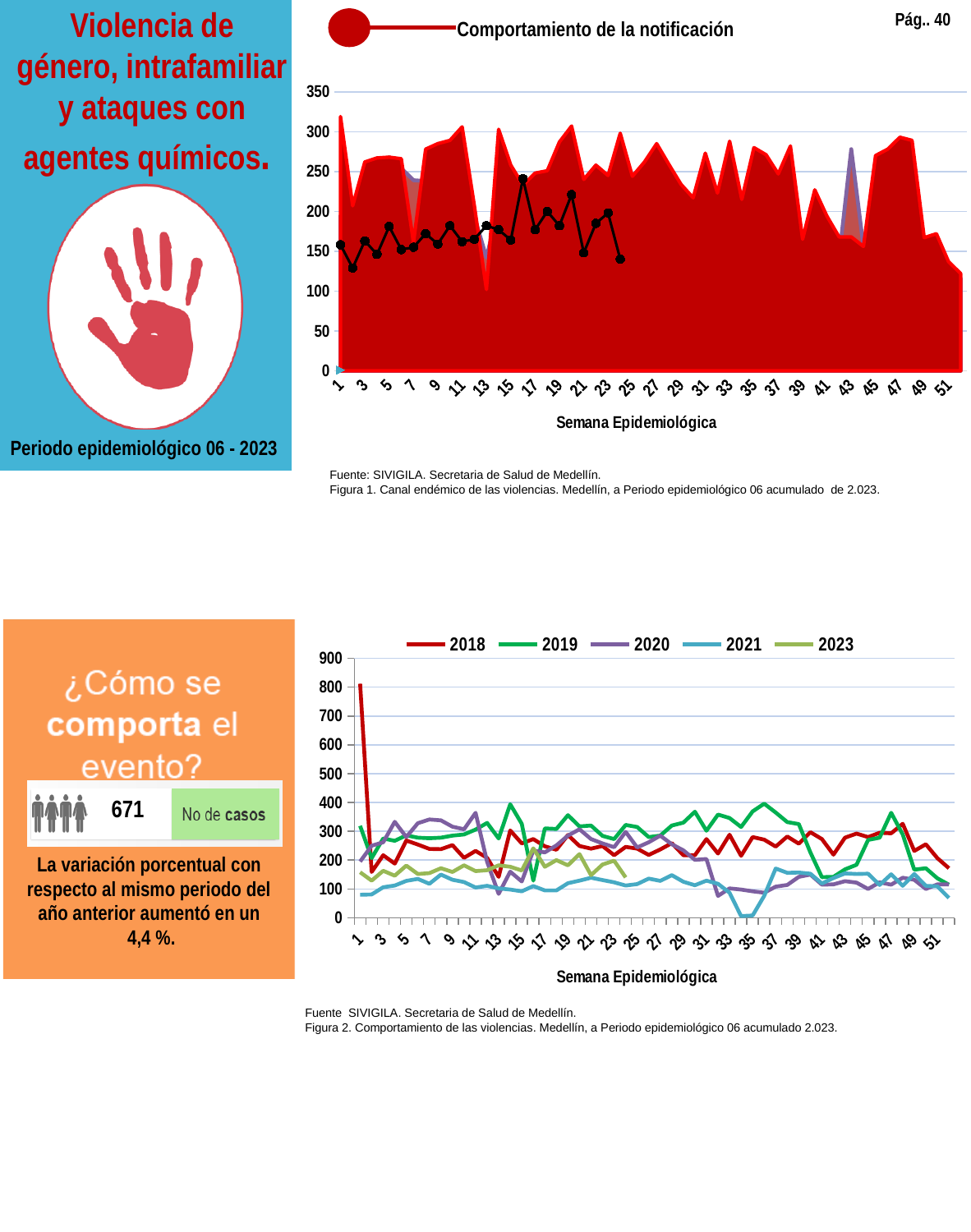
In the bottom chart, at week 1, which series has the larger value, 2018 or 2021? 2018 In the bottom chart, which series reaches the highest value anywhere on the chart? 2018 How many series does the legend of the bottom chart list? 5 What kind of chart is the top chart titled 'Comportamiento de la notificación'? area chart with a line In the top chart, is the top of the red area at week 1 greater or less than 300? greater What is the title of the top chart? Comportamiento de la notificación In the bottom chart, is the value of the 2019 series at week 36 greater or less than 300? greater In the bottom chart, is the value of the 2018 series at week 1 greater or less than 500? greater What is the x-axis title of the bottom chart? Semana Epidemiológica What kind of chart is the bottom chart with the legend 2018, 2019, 2020, 2021, 2023? line chart